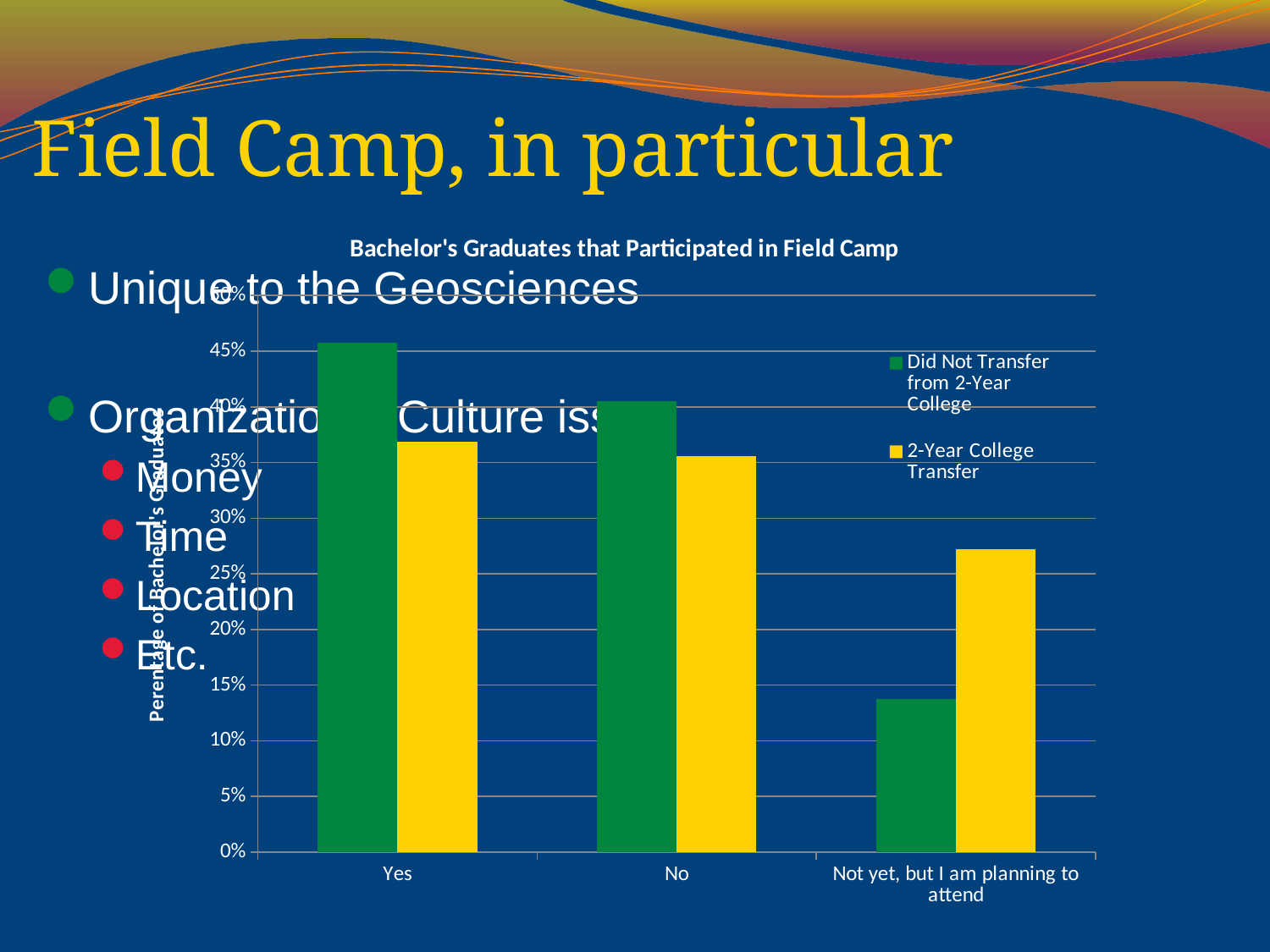
Which category has the lowest value for the '2-Year College Transfer' series? Not yet, but I am planning to attend Which category has the highest value for the 'Did Not Transfer from 2-Year College' series? Yes What kind of chart is shown on the slide? bar chart Do the values for the 'Did Not Transfer from 2-Year College' series rise or fall from left to right along the x axis? fall Which category has the lowest value for the 'Did Not Transfer from 2-Year College' series? Not yet, but I am planning to attend For the 'Yes' category, which series has the larger value? Did Not Transfer from 2-Year College What is the title of the chart? Bachelor's Graduates that Participated in Field Camp Is the value for 'Did Not Transfer from 2-Year College' in the 'Not yet, but I am planning to attend' category greater or less than 15%? less How many series does the legend list? 2 Is the value for 'Did Not Transfer from 2-Year College' in the 'Yes' category greater or less than 40%? greater How many categories are shown on the x axis? 3 For the 'Not yet, but I am planning to attend' category, which series has the larger value? 2-Year College Transfer